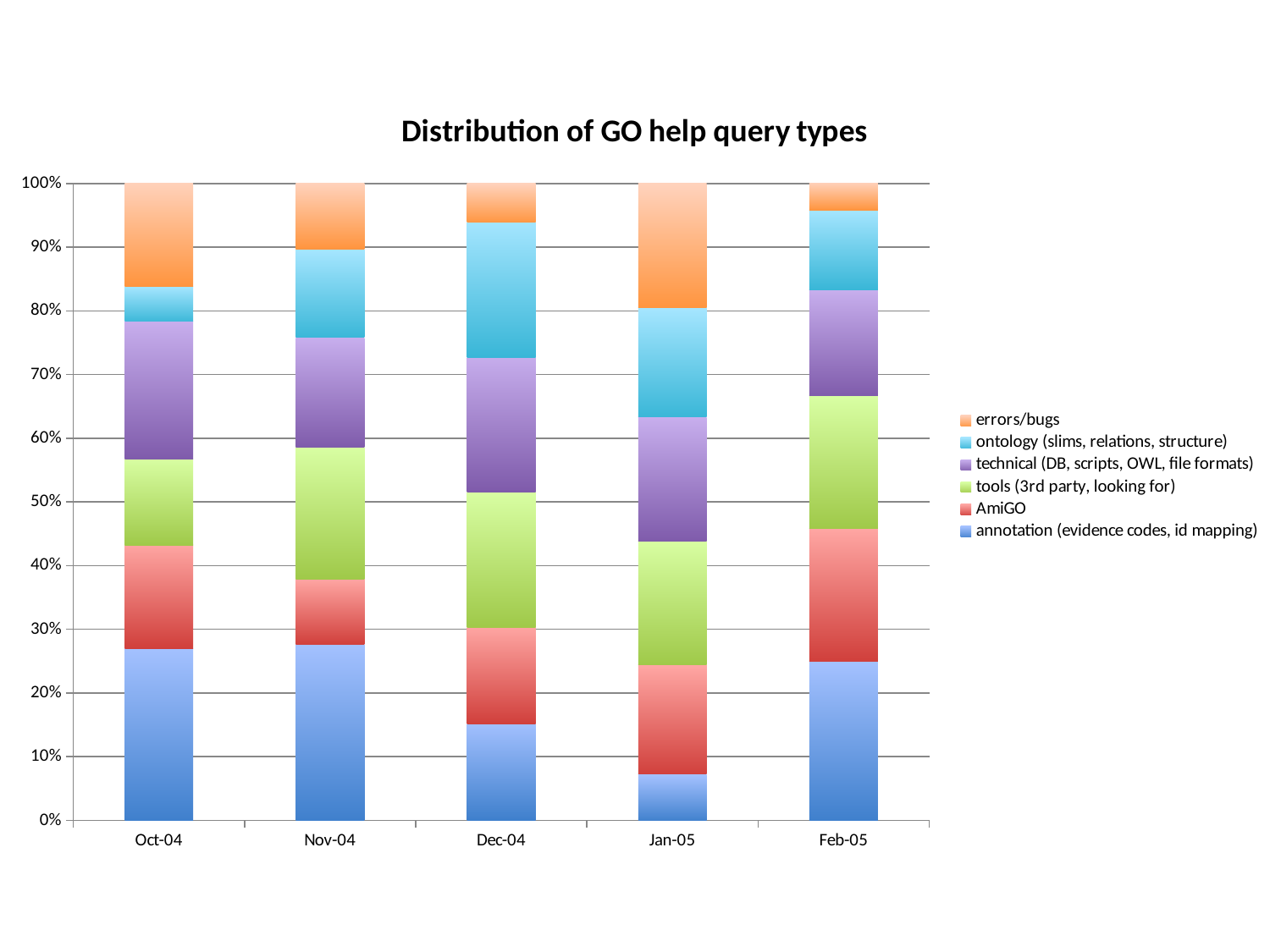
Which series is plotted at the bottom of each stacked bar? annotation (evidence codes, id mapping) Is the annotation (evidence codes, id mapping) share for Dec-04 greater or less than 20%? less Is the annotation (evidence codes, id mapping) share for Jan-05 greater or less than 10%? less What kind of chart is shown on the slide? Stacked bar chart What is the title of the chart? Distribution of GO help query types How many months are shown along the x axis? 5 What is the total height of each stacked bar? 100% Which month has the largest share for errors/bugs? Jan-05 In Dec-04, which segment is larger: ontology (slims, relations, structure) or errors/bugs? ontology (slims, relations, structure) Which month has the smallest share for annotation (evidence codes, id mapping)? Jan-05 How many series does the legend list? 6 Is the annotation (evidence codes, id mapping) share for Oct-04 greater or less than 20%? greater